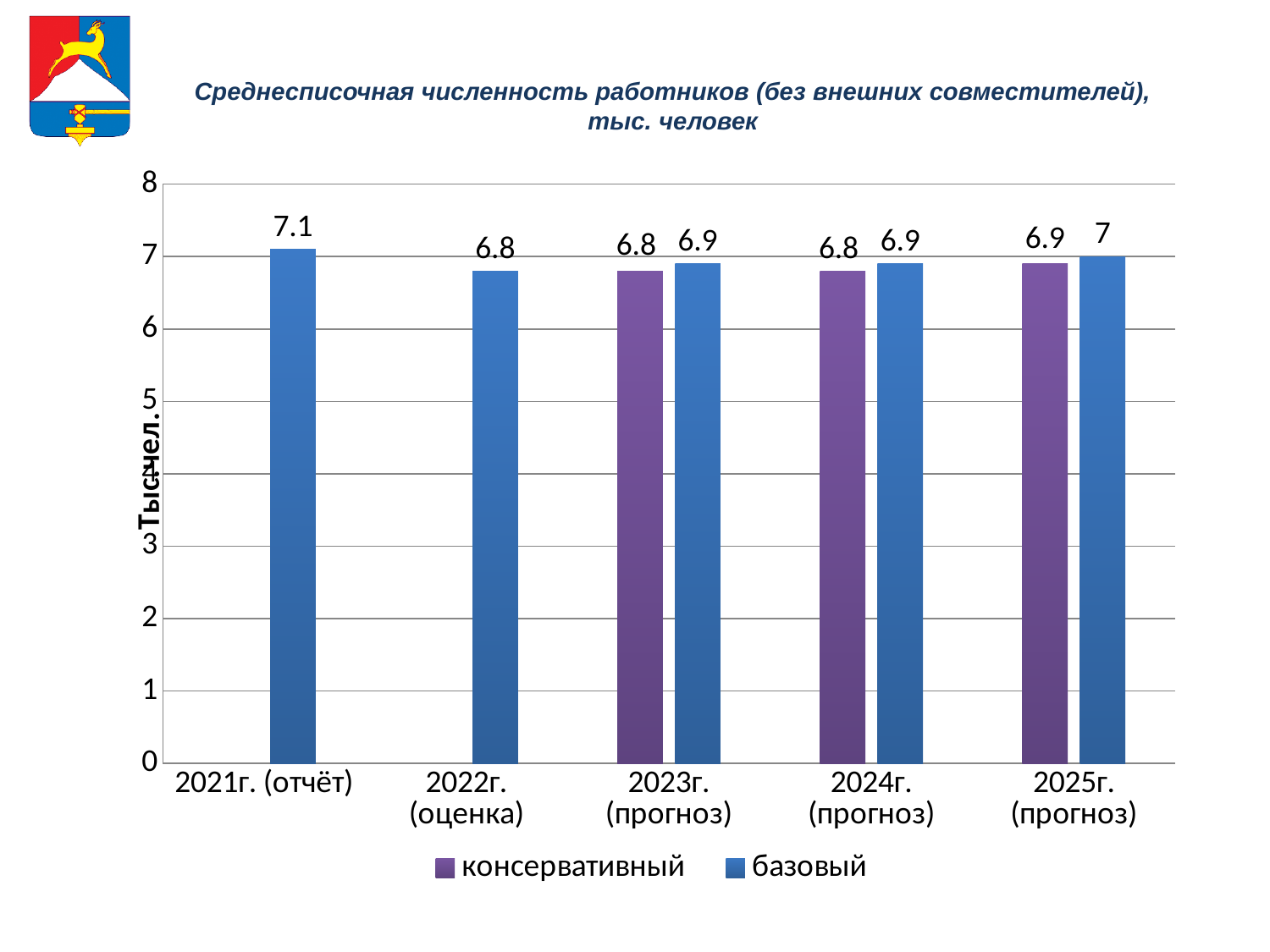
For 2023г. (прогноз), which series has the larger value, консервативный or базовый? базовый What is the difference between the базовый value for 2021г. (отчёт) and the базовый value for 2022г. (оценка)? 0.3 What kind of chart is shown on the slide? bar chart What is the value of the консервативный series for 2025г. (прогноз)? 6.9 What colour are the bars of the консервативный series? purple What is the value of the базовый series for 2021г. (отчёт)? 7.1 How many series does the legend list? 2 How many categories are shown on the x axis? 5 What is the value of the консервативный series for 2024г. (прогноз)? 6.8 What is the difference between the базовый and консервативный values for 2025г. (прогноз)? 0.1 Which category has the highest value in the базовый series? 2021г. (отчёт) What is the value of the базовый series for 2025г. (прогноз)? 7